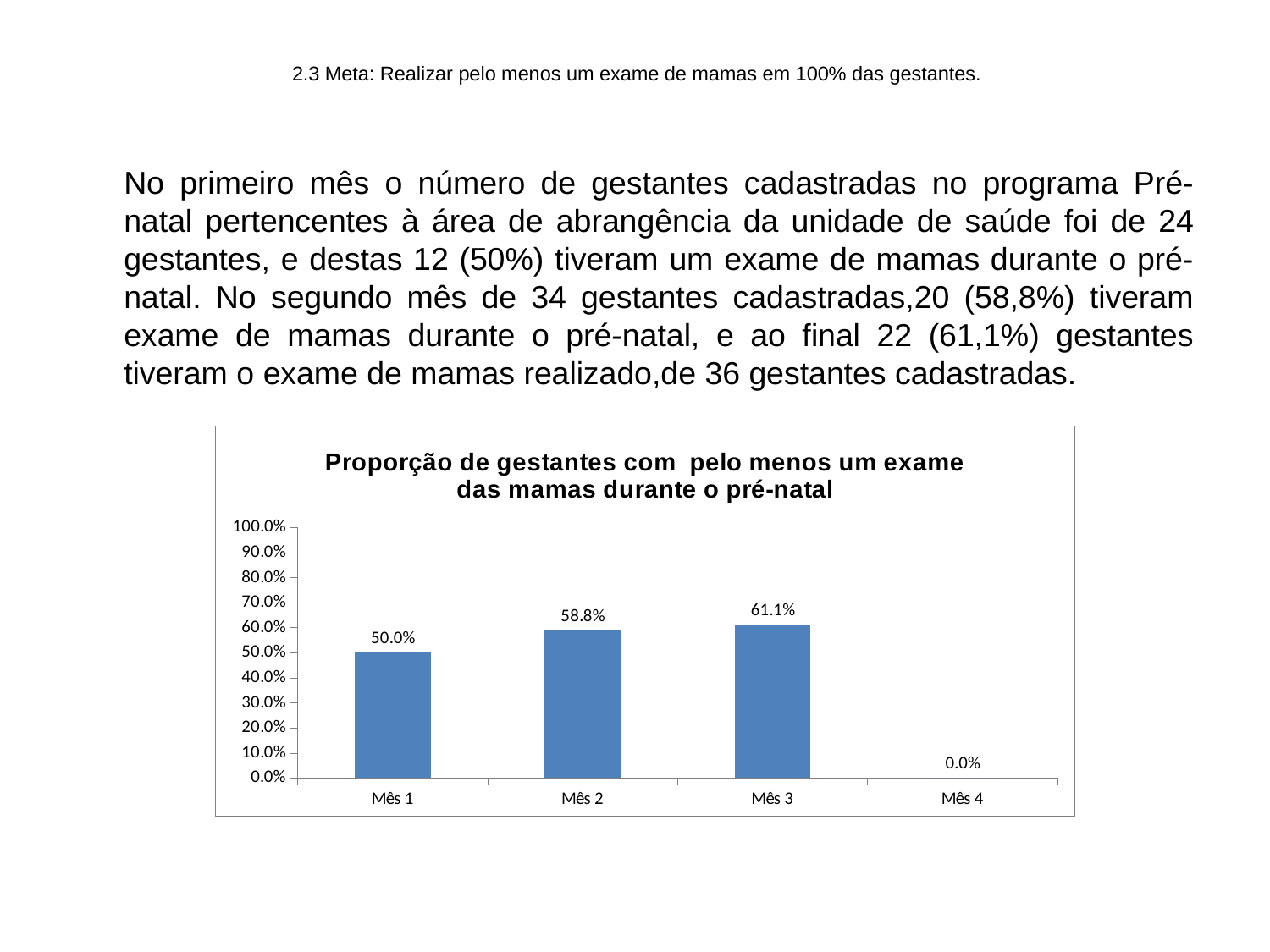
What is the title of the chart? Proporção de gestantes com pelo menos um exame das mamas durante o pré-natal Which month has the highest value? Mês 3 How many months are shown on the x axis? 4 What is the value for Mês 2? 58.8% What is the value for Mês 3? 61.1% Is the value for Mês 3 greater or less than 50.0%? greater Which is larger, the value for Mês 2 or the value for Mês 1? Mês 2 What is the difference between the values for Mês 3 and Mês 1? 11.1% Which month has the lowest value? Mês 4 What kind of chart is shown? bar chart What is the value for Mês 4? 0.0% What is the value for Mês 1? 50.0%